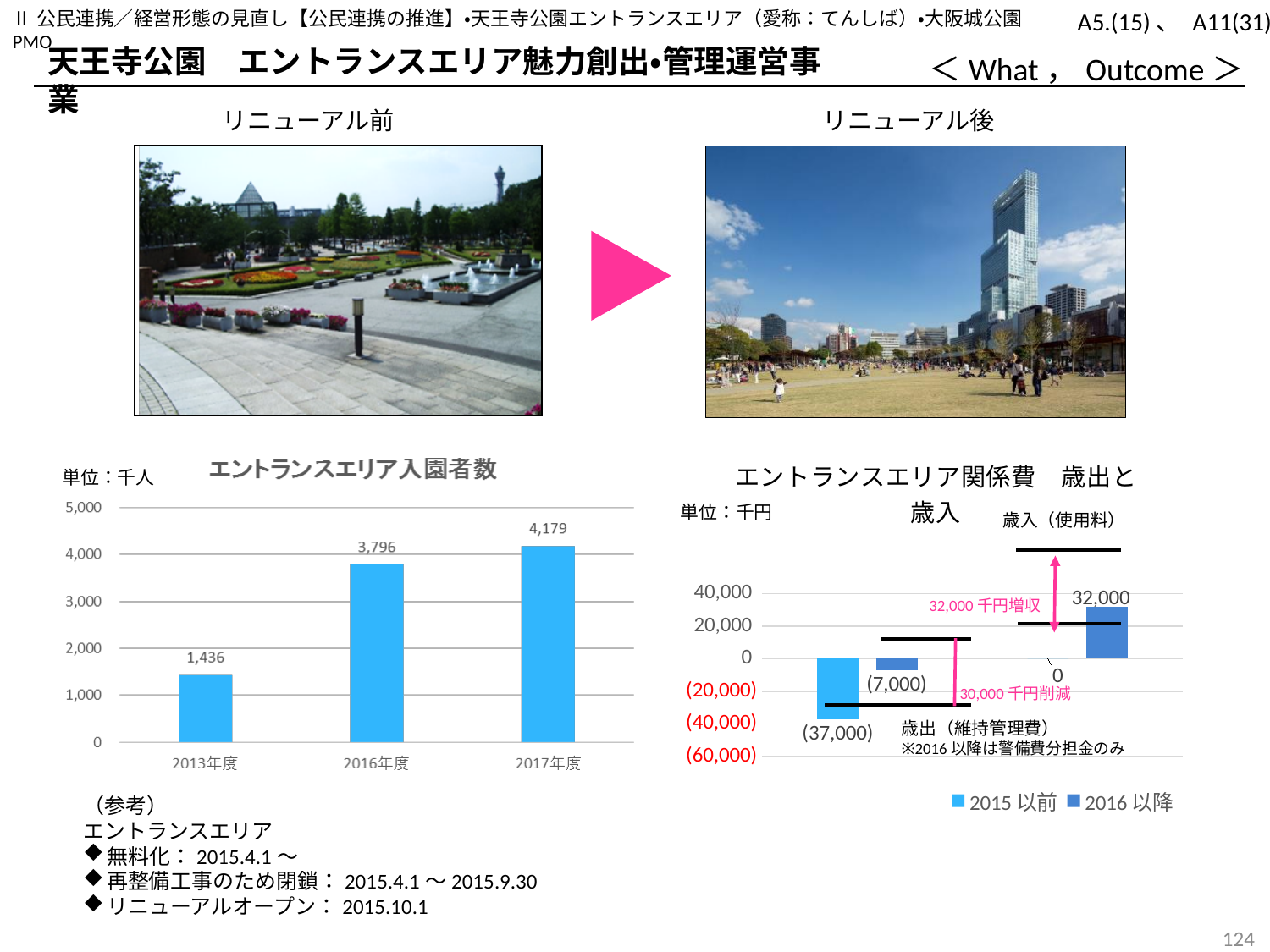
In the エントランスエリア入園者数 chart, which year has the highest value? 2017年度 In the エントランスエリア入園者数 chart, what is the value for 2017年度? 4,179 In the エントランスエリア入園者数 chart, what is the difference between the values for 2017年度 and 2016年度? 383 In the エントランスエリア入園者数 chart, do the values rise or fall from 2013年度 to 2017年度? rise In the エントランスエリア関係費 歳出と歳入 chart, what is the 歳出（維持管理費） value for 2015以前? (37,000) In the エントランスエリア入園者数 chart, what is the value for 2013年度? 1,436 In the エントランスエリア入園者数 chart, how many years are plotted? 3 In the エントランスエリア入園者数 chart, which year has the lowest value? 2013年度 In the エントランスエリア関係費 歳出と歳入 chart, what is the 歳入（使用料） value for 2016以降? 32,000 In the エントランスエリア関係費 歳出と歳入 chart, what unit is stated for the values? 千円 What kind of chart is the エントランスエリア入園者数 chart? bar chart In the エントランスエリア関係費 歳出と歳入 chart, how many series does the legend list? 2